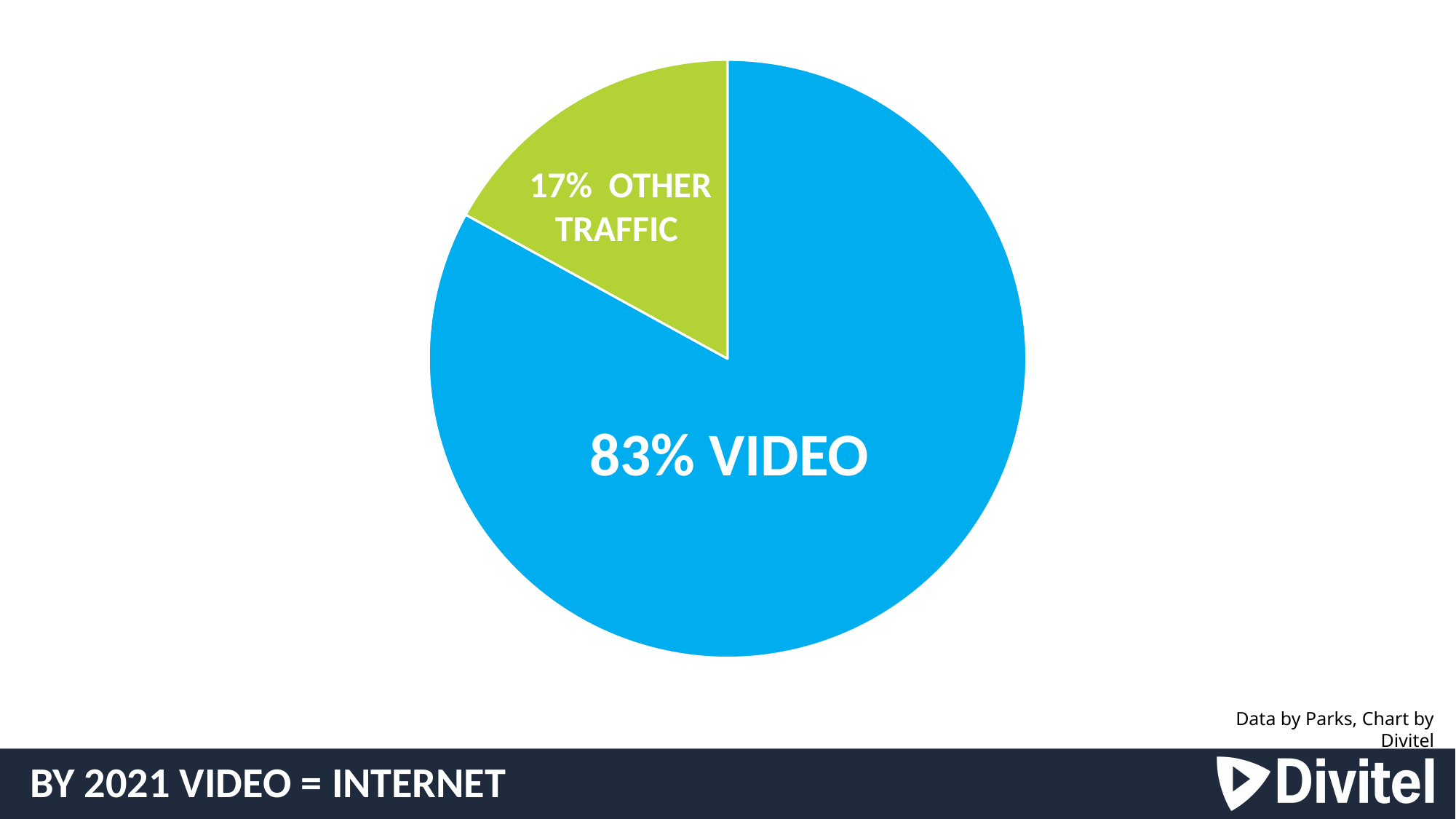
Which is larger, the VIDEO slice or the OTHER TRAFFIC slice? VIDEO What is the total of the two slices shown? 100% What kind of chart is shown on the slide? pie chart What colour is the OTHER TRAFFIC slice? green How many slices does the pie chart have? 2 What is the difference in percentage points between the VIDEO slice and the OTHER TRAFFIC slice? 66 What share of the pie does VIDEO take? 83% What share of the pie does OTHER TRAFFIC take? 17% What colour is the VIDEO slice? blue Which slice is the largest? VIDEO Which slice is the smallest? OTHER TRAFFIC